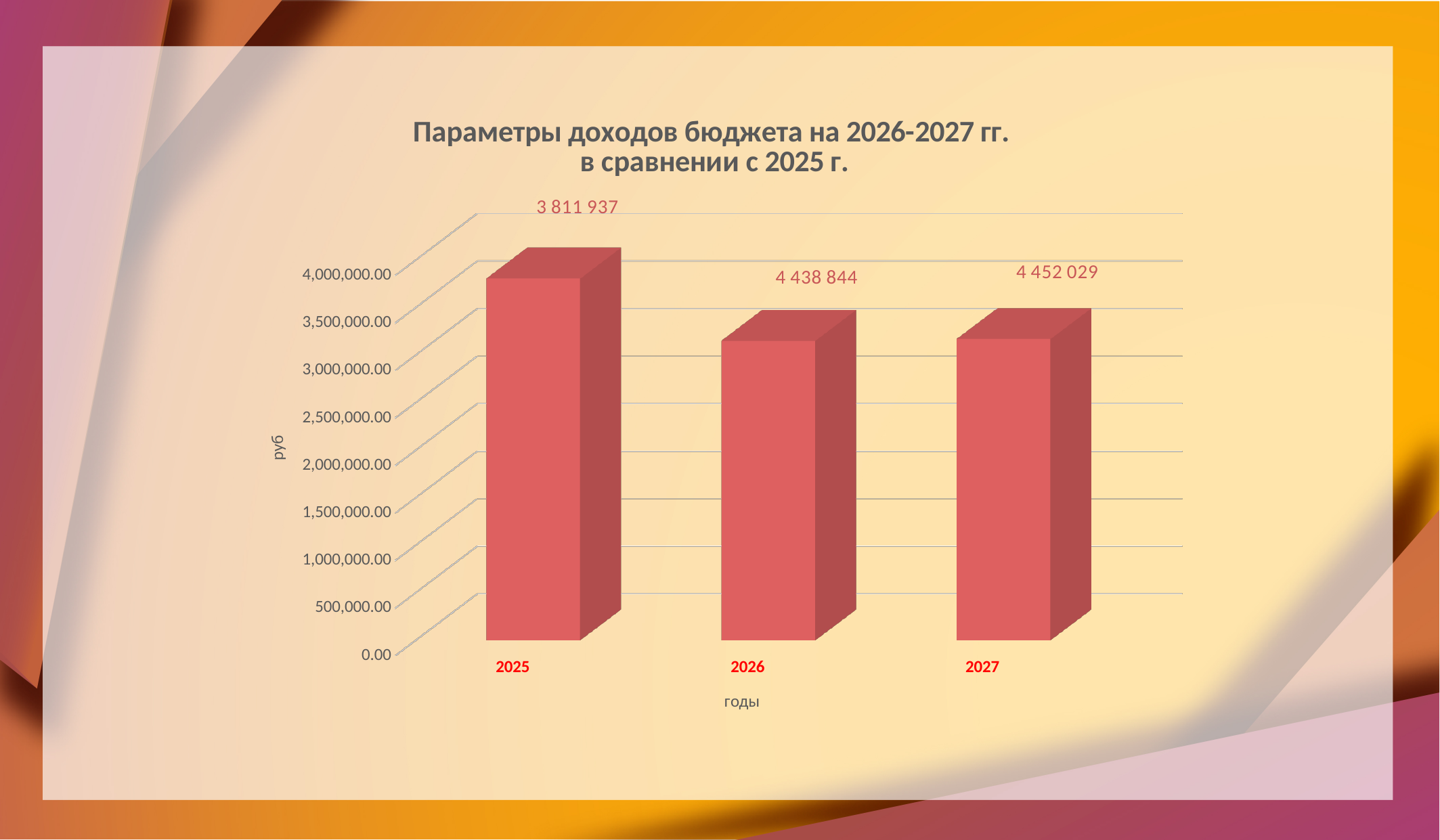
What kind of chart is shown on the slide? bar chart What is the title of the chart? Параметры доходов бюджета на 2026-2027 гг. в сравнении с 2025 г. What value is labelled for 2025? 3 811 937 How many years are shown on the x axis? 3 Is the value for 2025 greater or less than 4,000,000.00? less What is the difference between the labelled values for 2027 and 2026? 13 185 What value is labelled for 2027? 4 452 029 What is the difference between the labelled values for 2026 and 2025? 626 907 Is the value for 2025 greater or less than 3,500,000.00? greater What value is labelled for 2026? 4 438 844 What is the label of the vertical axis? руб